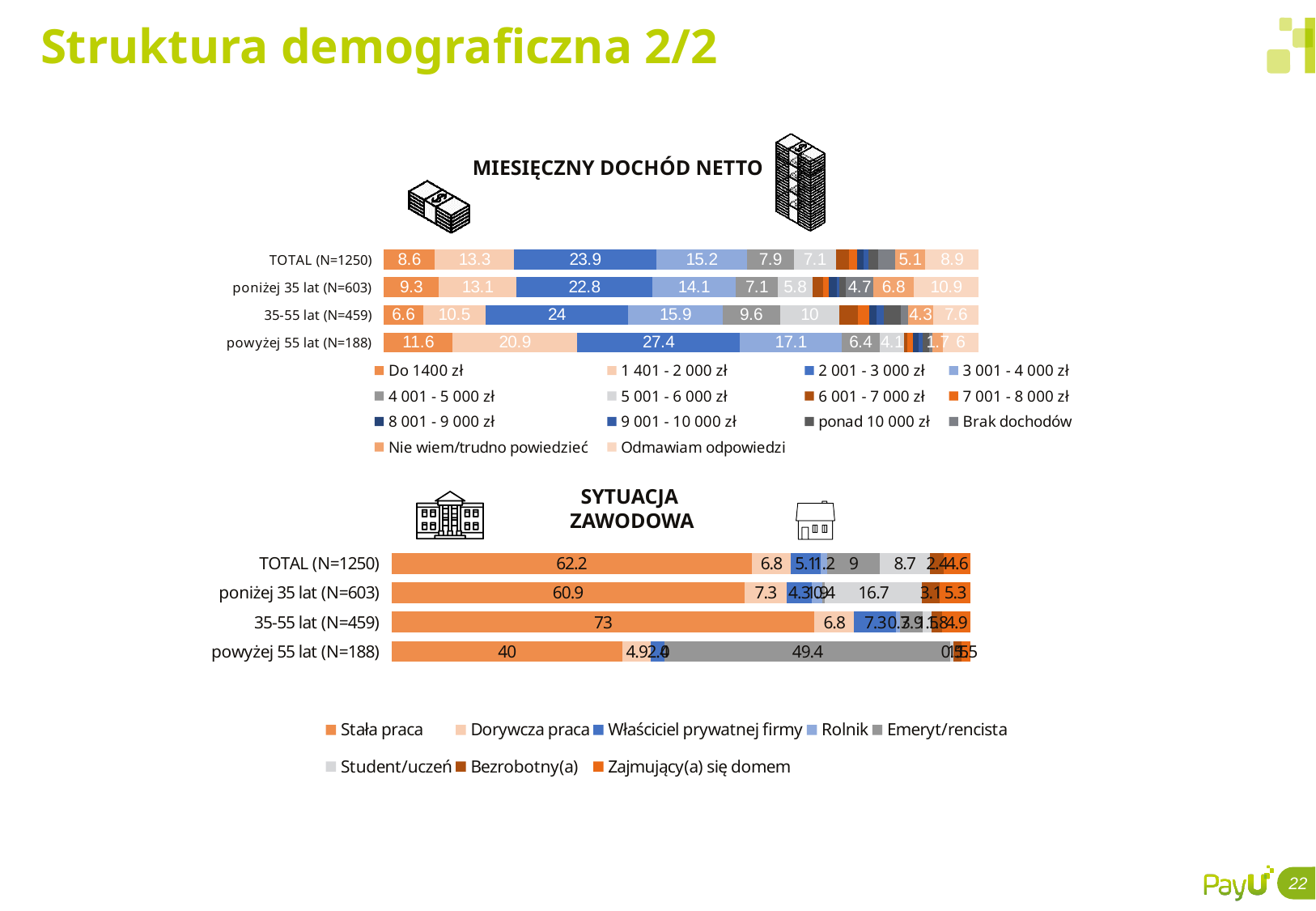
How many series does the legend of the "SYTUACJA ZAWODOWA" chart list? 8 In the "MIESIĘCZNY DOCHÓD NETTO" chart, what is the value for "Do 1400 zł" in the TOTAL (N=1250) row? 8.6 In the "MIESIĘCZNY DOCHÓD NETTO" chart, which age group has the lowest value for "Do 1400 zł"? 35-55 lat (N=459) In the "SYTUACJA ZAWODOWA" chart, what is the value for "Emeryt/rencista" in the powyżej 55 lat (N=188) row? 49.4 How many age-group rows (categories) does the "SYTUACJA ZAWODOWA" chart show? 4 In the "SYTUACJA ZAWODOWA" chart, which age group has the highest value for "Stała praca"? 35-55 lat (N=459) How many series does the legend of the "MIESIĘCZNY DOCHÓD NETTO" chart list? 14 In the "MIESIĘCZNY DOCHÓD NETTO" chart, what is the value for "2 001 - 3 000 zł" in the powyżej 55 lat (N=188) row? 27.4 In the "SYTUACJA ZAWODOWA" chart, what is the value for "Stała praca" in the 35-55 lat (N=459) row? 73 In the "MIESIĘCZNY DOCHÓD NETTO" chart, what is the difference between the "2 001 - 3 000 zł" values for powyżej 55 lat (N=188) and poniżej 35 lat (N=603)? 4.6 In the "SYTUACJA ZAWODOWA" chart, which is larger for "Stała praca": TOTAL (N=1250) or poniżej 35 lat (N=603)? TOTAL (N=1250) What kind of chart is the "MIESIĘCZNY DOCHÓD NETTO" chart? Stacked bar chart